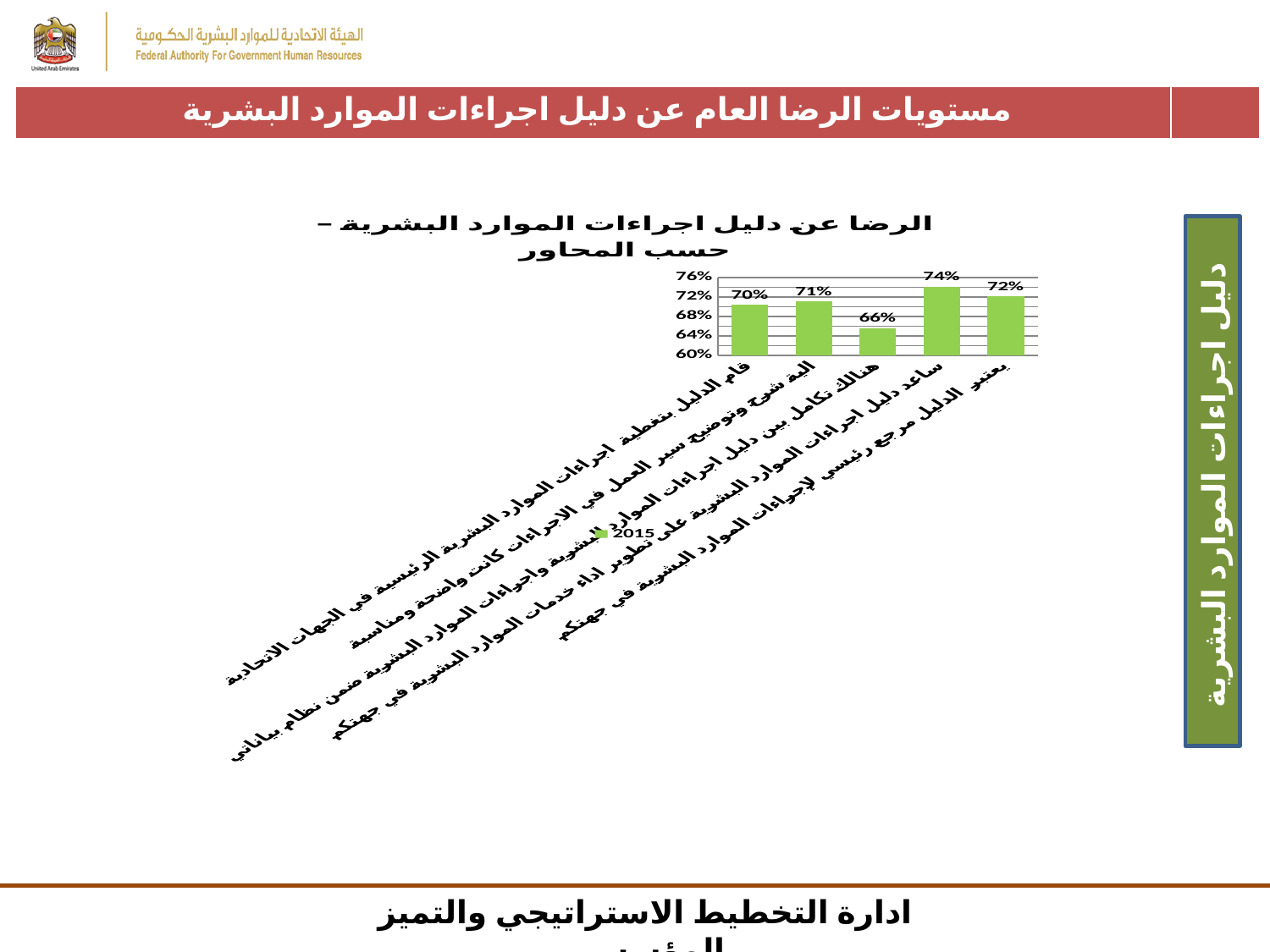
How many bars (categories) does the chart show? 5 Which bar has the lowest value? the third bar (هنالك تكامل بين دليل اجراءات الموارد البشرية واجراءات الموارد البشرية ضمن نظام بياناتي), 66% What is the value of the fifth (rightmost) bar, for the statement that the guide is a main reference for HR procedures (يعتبر الدليل مرجع رئيسي)? 72% What is the value of the second bar, for the statement that the workflow explanation was clear and appropriate (آلية شرح وتوضيح سير العمل)? 71% Which bar has the highest value? the fourth bar (ساعد دليل اجراءات الموارد البشرية على تطوير اداء خدمات الموارد البشرية), 74% How many series does the chart legend list? 1 What is the difference between the highest value (74%) and the lowest value (66%) in the chart? 8% What is the value of the fourth bar, for the statement that the guide helped improve HR service performance (ساعد دليل اجراءات الموارد البشرية على تطوير اداء)? 74% What is the value of the first (leftmost) bar, for the statement that the guide covers the main HR procedures in federal entities (قام الدليل بتغطية اجراءات الموارد البشرية الرئيسية)? 70% What type of chart is shown on the slide? bar chart What year does the legend entry show? 2015 What is the value of the third (middle) bar, about integration between the HR procedures guide and the Bayanati system (هنالك تكامل بين دليل اجراءات الموارد البشرية)? 66%